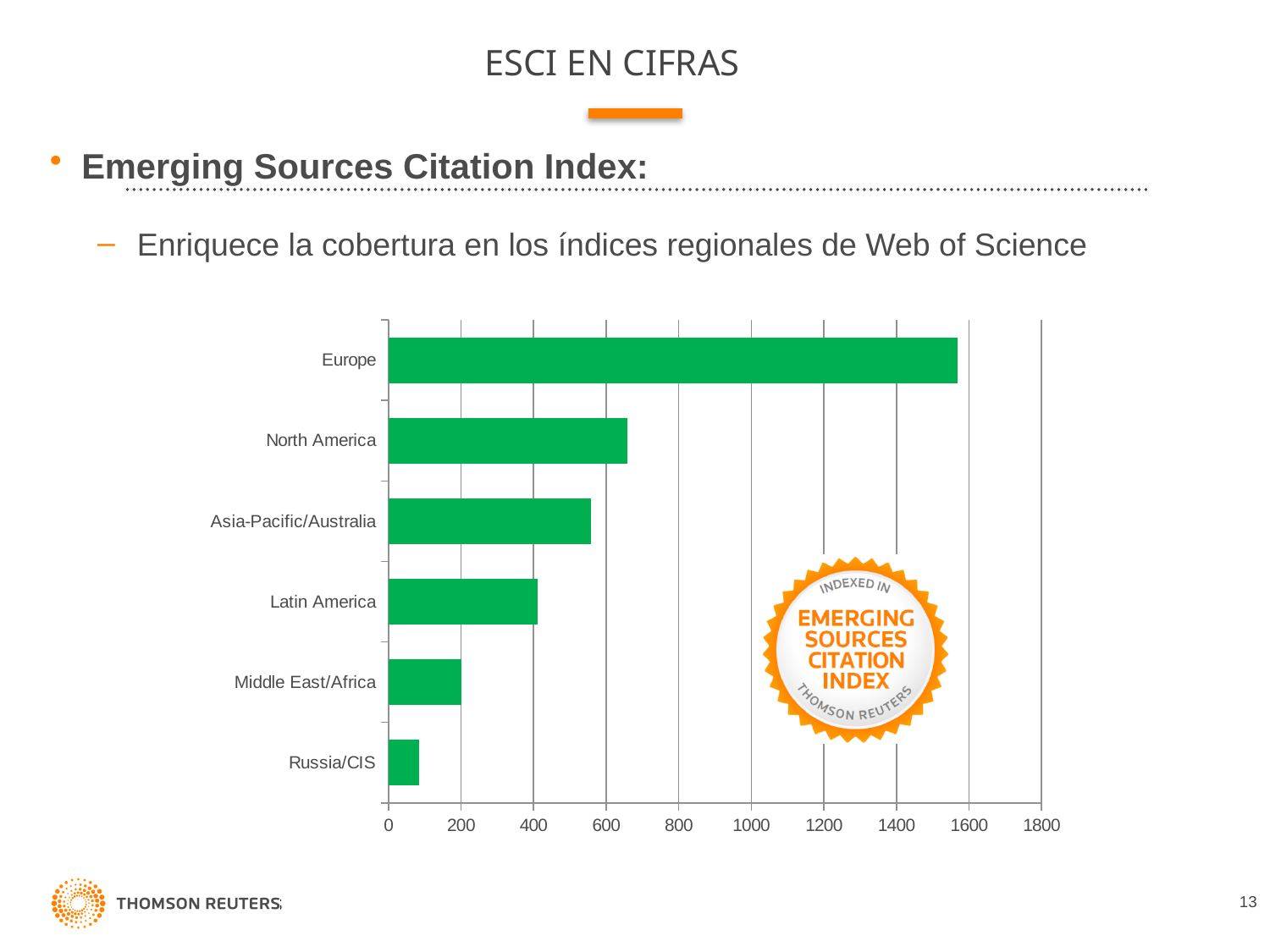
Is the value for Russia/CIS greater or less than 200? less Which region has the lowest value in the bar chart? Russia/CIS Which has the larger value, North America or Asia-Pacific/Australia? North America Is the value for Europe greater or less than 1400? greater Is the value for North America greater or less than 600? greater What is the maximum value shown on the horizontal axis of the bar chart? 1800 How many regions are shown in the bar chart? 6 What kind of chart is shown on the slide? bar chart Which region has the highest value in the bar chart? Europe